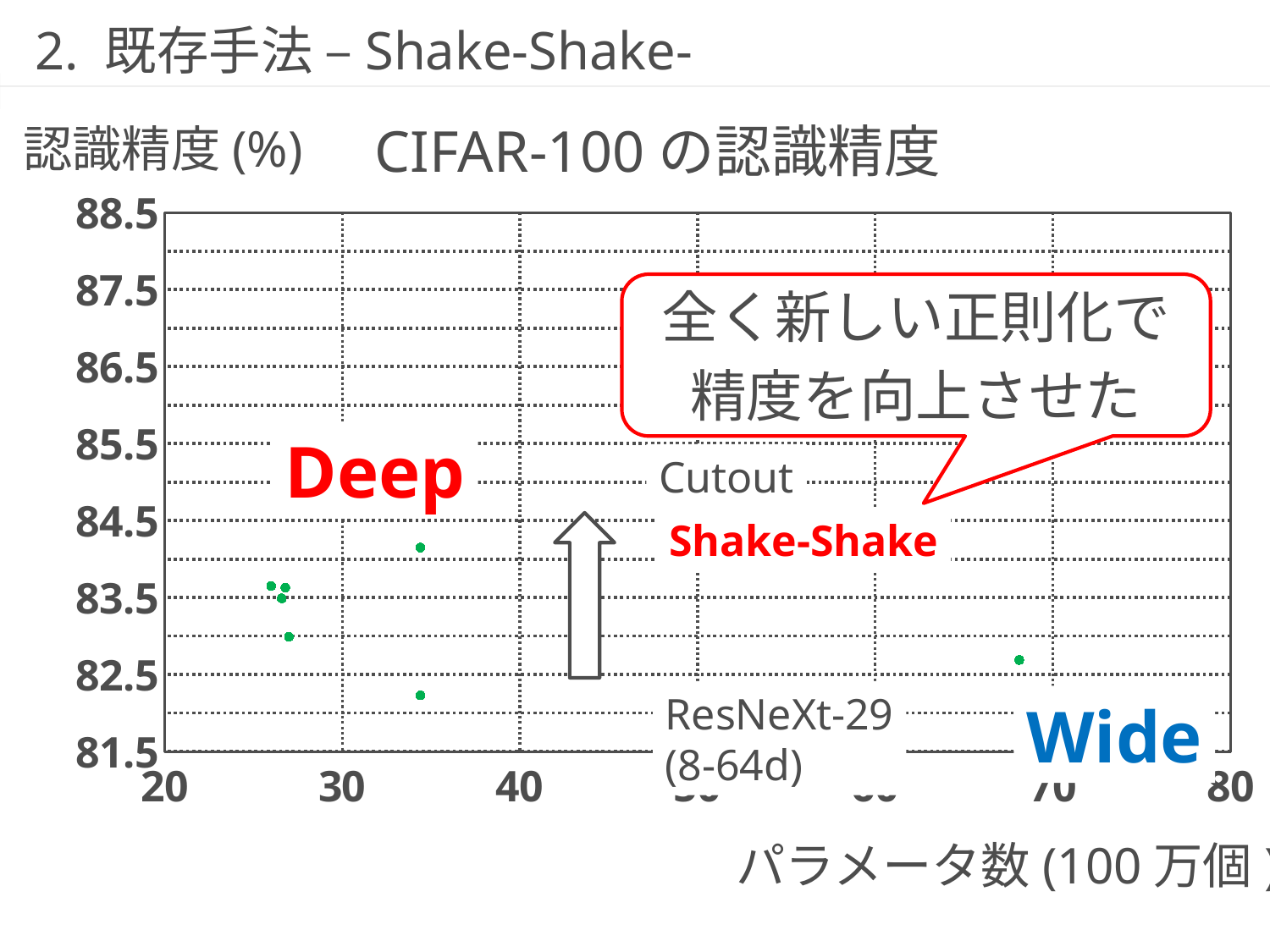
Which has the higher accuracy: the data point near 68 on the x axis or the topmost data point near 26 on the x axis? the point near 26 What kind of chart is shown on the slide? scatter chart Is the value of the rightmost data point (near 68 on the x axis) greater or less than 83.5? less Which has the higher accuracy: the highest data point near 35 on the x axis or the data point near 68 on the x axis? the point near 35 What is the title of the chart? CIFAR-100 の認識精度 Is the value of the highest data point near 35 on the x axis greater or less than 83.5? greater Is the value of the rightmost data point (near 68 on the x axis) greater or less than 82.5? greater What colour are the plotted data points? green